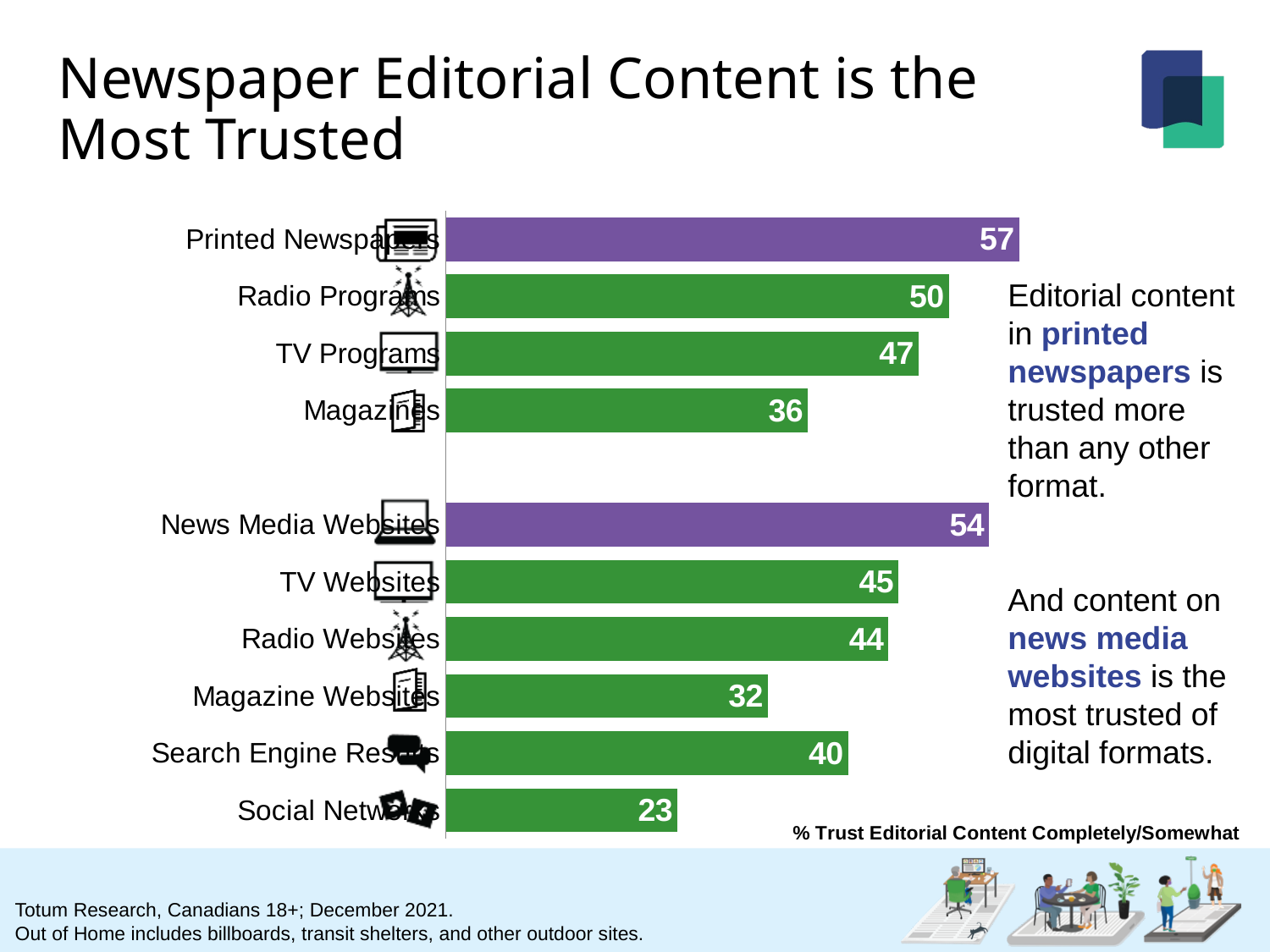
What kind of chart is shown on the slide? Bar chart Which category has the lowest value? Social Networks What is the value for News Media Websites? 54 What does the label below the chart say the values represent? % Trust Editorial Content Completely/Somewhat What is the difference between the values for Radio Programs and Magazines? 14 What is the value for Search Engine Results? 40 Which category has the highest value? Printed Newspapers What is the value for Printed Newspapers? 57 Which is larger, the value for TV Websites or the value for Radio Websites? TV Websites What is the value for Social Networks? 23 How many categories are shown in the chart? 10 What is the difference between the values for Printed Newspapers and News Media Websites? 3